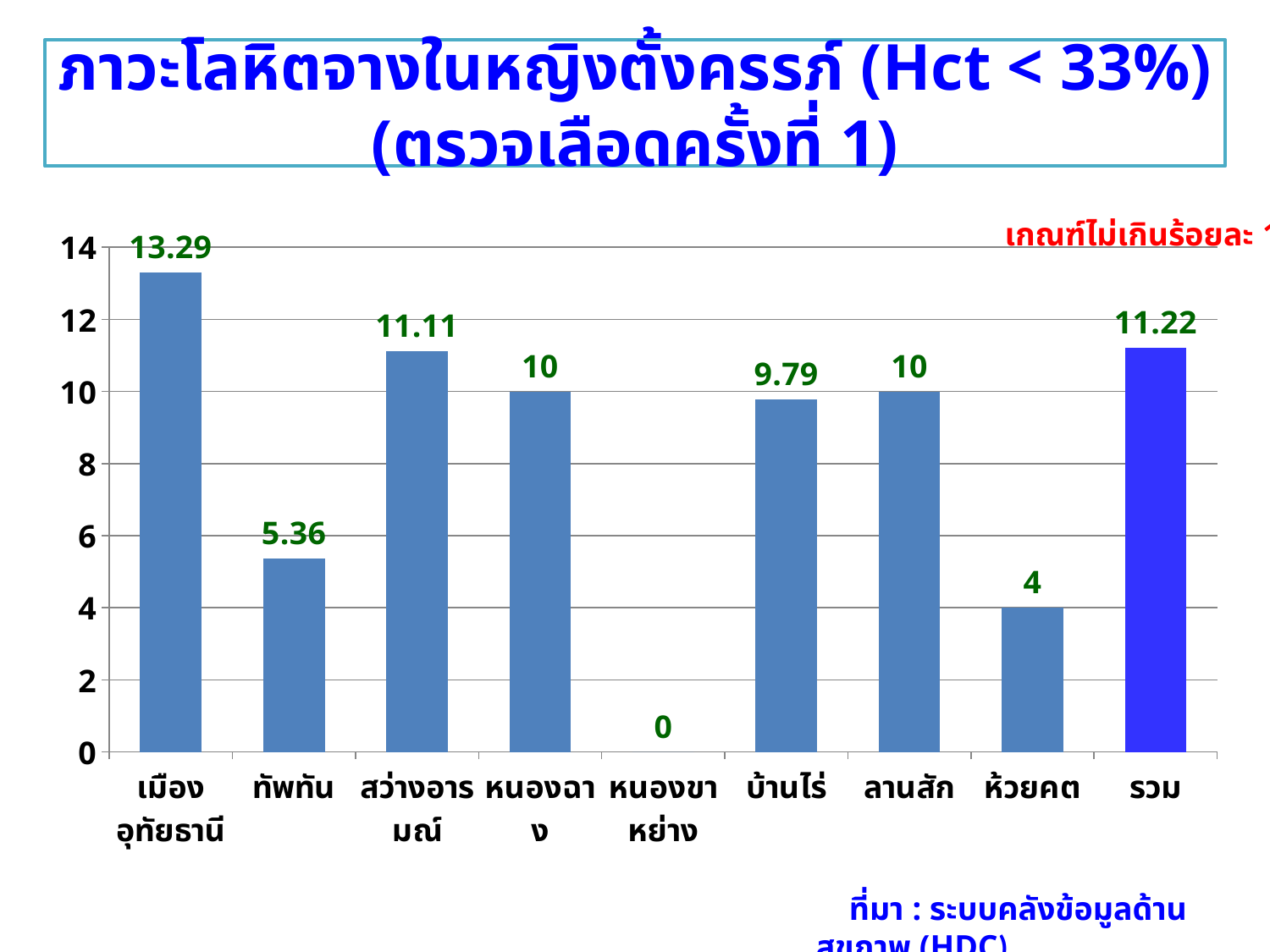
Is the value for ห้วยคต greater or less than 6? less Which bar is coloured differently from the others? รวม What is the value for รวม? 11.22 What is the value for ทัพทัน? 5.36 What is the difference between the values for เมืองอุทัยธานี and ทัพทัน? 7.93 Which category has the lowest value? หนองขาหย่าง Which category has the highest value? เมืองอุทัยธานี What kind of chart is shown on the slide? bar chart Which is larger, the value for สว่างอารมณ์ or the value for บ้านไร่? สว่างอารมณ์ What is the value for บ้านไร่? 9.79 What is the value for เมืองอุทัยธานี? 13.29 How many categories are shown on the x axis? 9